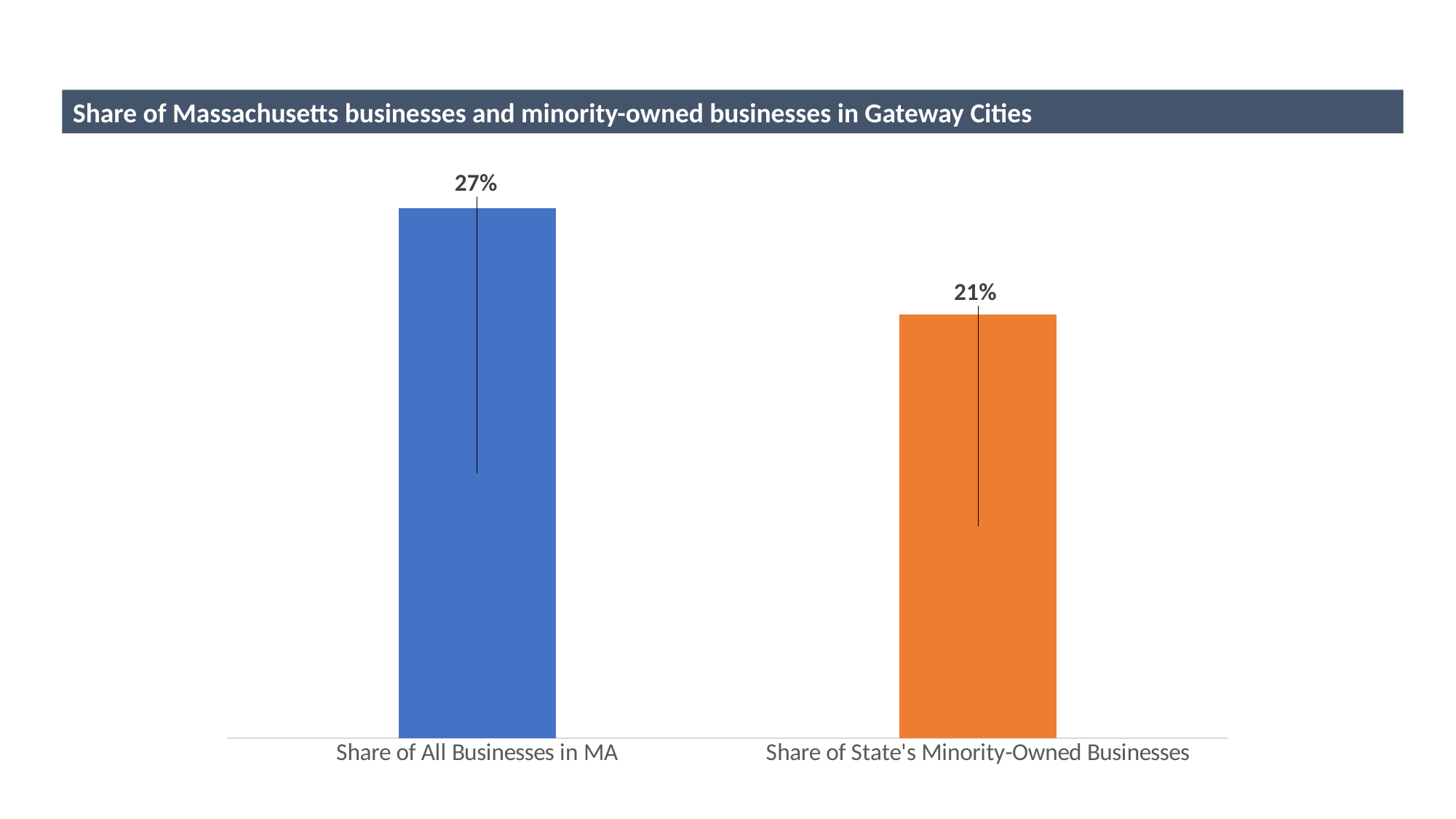
What kind of chart is shown on the slide? Bar chart Which is larger: Share of All Businesses in MA or Share of State's Minority-Owned Businesses? Share of All Businesses in MA What is the value for Share of State's Minority-Owned Businesses? 21% How many categories are shown in the chart? 2 What is the value for Share of All Businesses in MA? 27% Which category has the highest value? Share of All Businesses in MA What is the difference between Share of All Businesses in MA and Share of State's Minority-Owned Businesses? 6% What colour is the bar for Share of State's Minority-Owned Businesses? Orange What is the title of the chart? Share of Massachusetts businesses and minority-owned businesses in Gateway Cities Which category has the lowest value? Share of State's Minority-Owned Businesses Do the values rise or fall from left to right across the categories? Fall